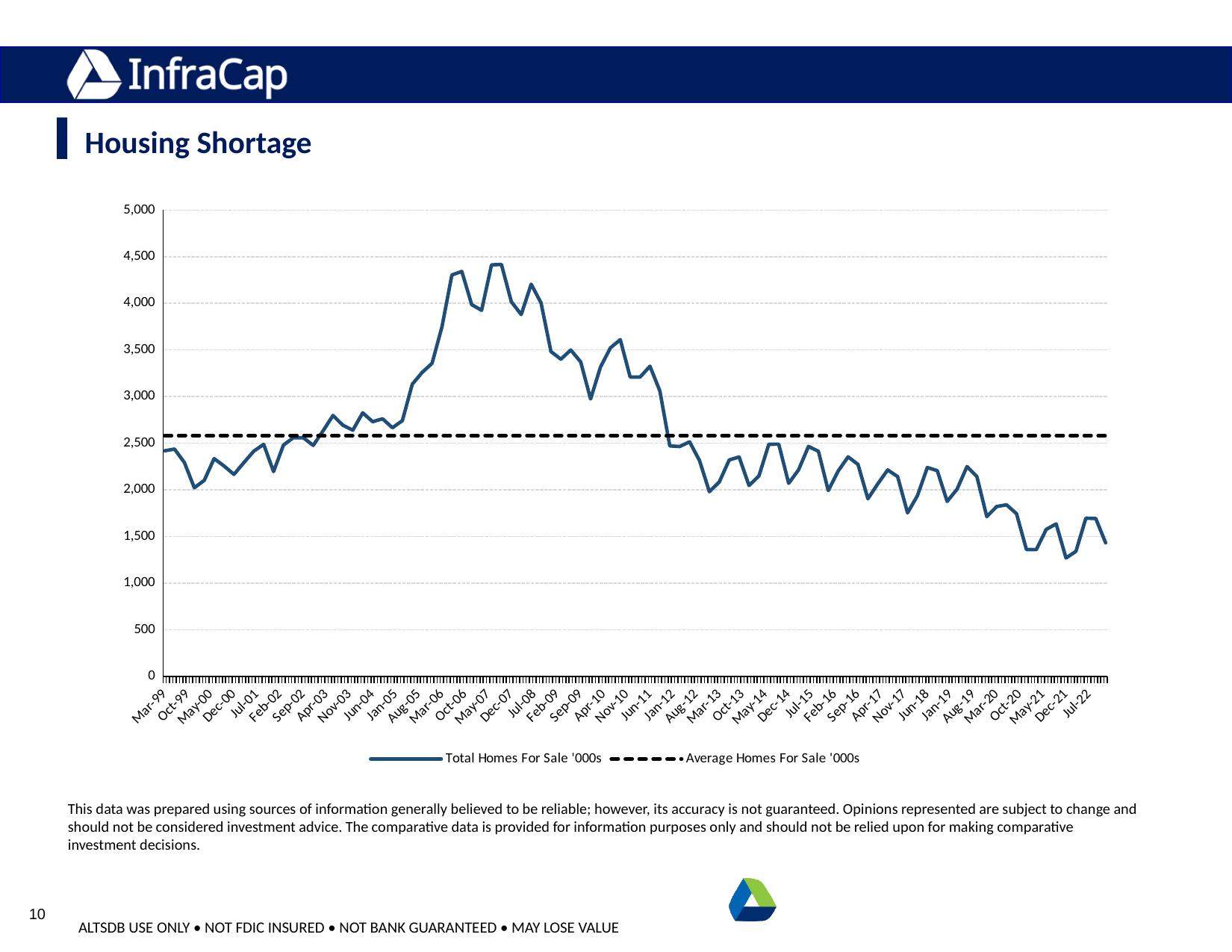
Does Total Homes For Sale '000s generally rise or fall from Dec-07 to Jul-22? fall Is the value of Total Homes For Sale '000s at Mar-99 greater or less than 2,000? greater What kind of chart is shown on the slide? line chart How many series does the legend list? 2 Which is larger, Total Homes For Sale '000s at Dec-07 or at Jul-22? Dec-07 Is the Average Homes For Sale '000s line greater or less than 3,000? less Is the value of Total Homes For Sale '000s at Oct-06 greater or less than 4,000? greater What are the two series named in the legend? Total Homes For Sale '000s and Average Homes For Sale '000s Which is larger, Total Homes For Sale '000s at Mar-99 or at Oct-20? Mar-99 Which series is drawn as a dashed line? Average Homes For Sale '000s